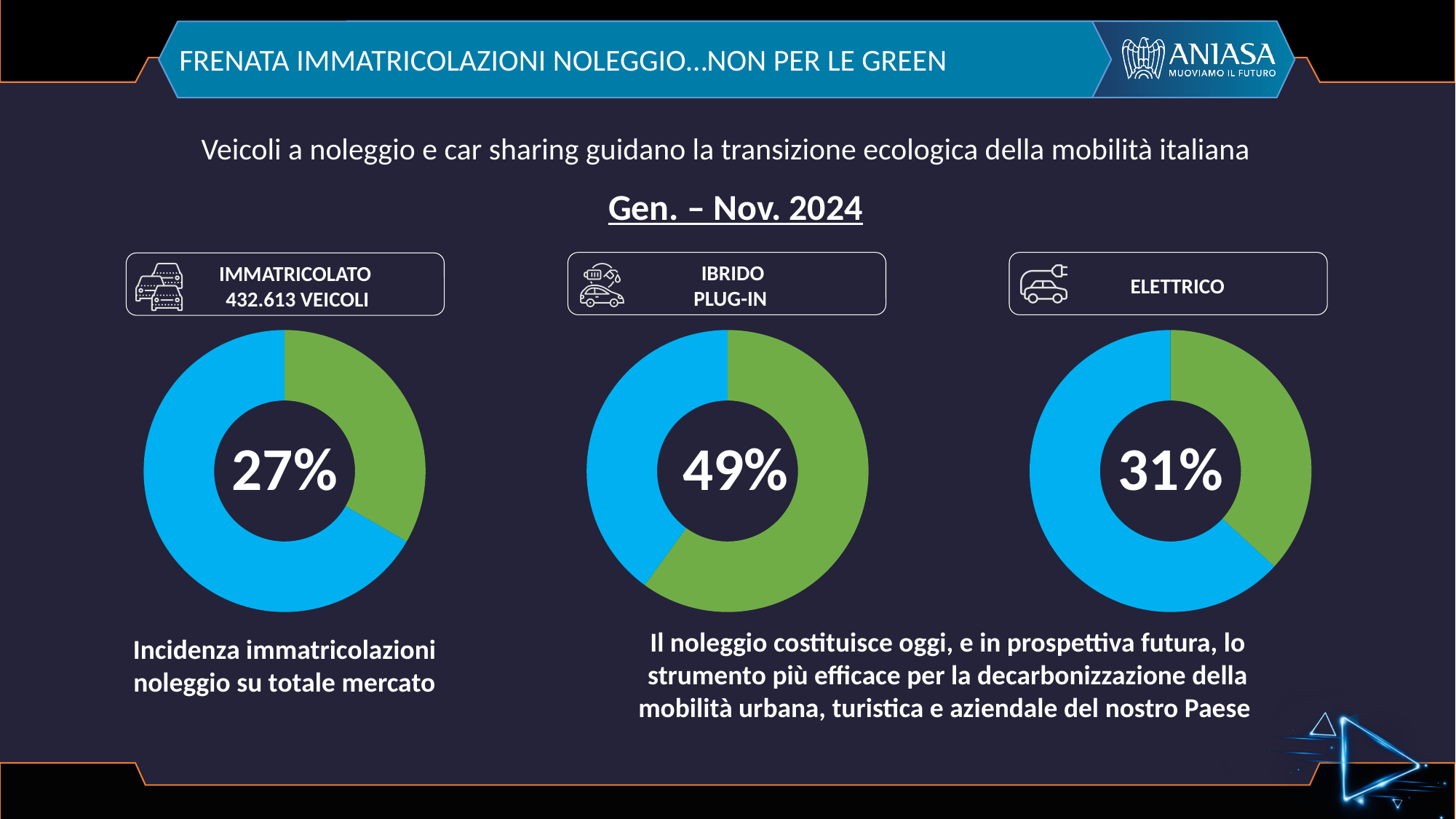
What kind of chart is used to show the three percentages on the slide? Donut (pie) chart What is the difference in percentage points between the IBRIDO PLUG-IN chart and the IMMATRICOLATO chart? 22 percentage points What total number of vehicles is stated in the IMMATRICOLATO label above the first donut chart? 432.613 VEICOLI In the IMMATRICOLATO donut chart, what percentage is shown in the centre? 27% Which is larger, the percentage in the ELETTRICO chart or the percentage in the IBRIDO PLUG-IN chart? IBRIDO PLUG-IN How many donut charts are shown on the slide? 3 In the IBRIDO PLUG-IN donut chart, what percentage is shown in the centre? 49% In the ELETTRICO donut chart, what percentage is shown in the centre? 31% Across the three donut charts, which category has the highest percentage? IBRIDO PLUG-IN Across the three donut charts, which category has the lowest percentage? IMMATRICOLATO What is the difference in percentage points between the ELETTRICO chart and the IMMATRICOLATO chart? 4 percentage points